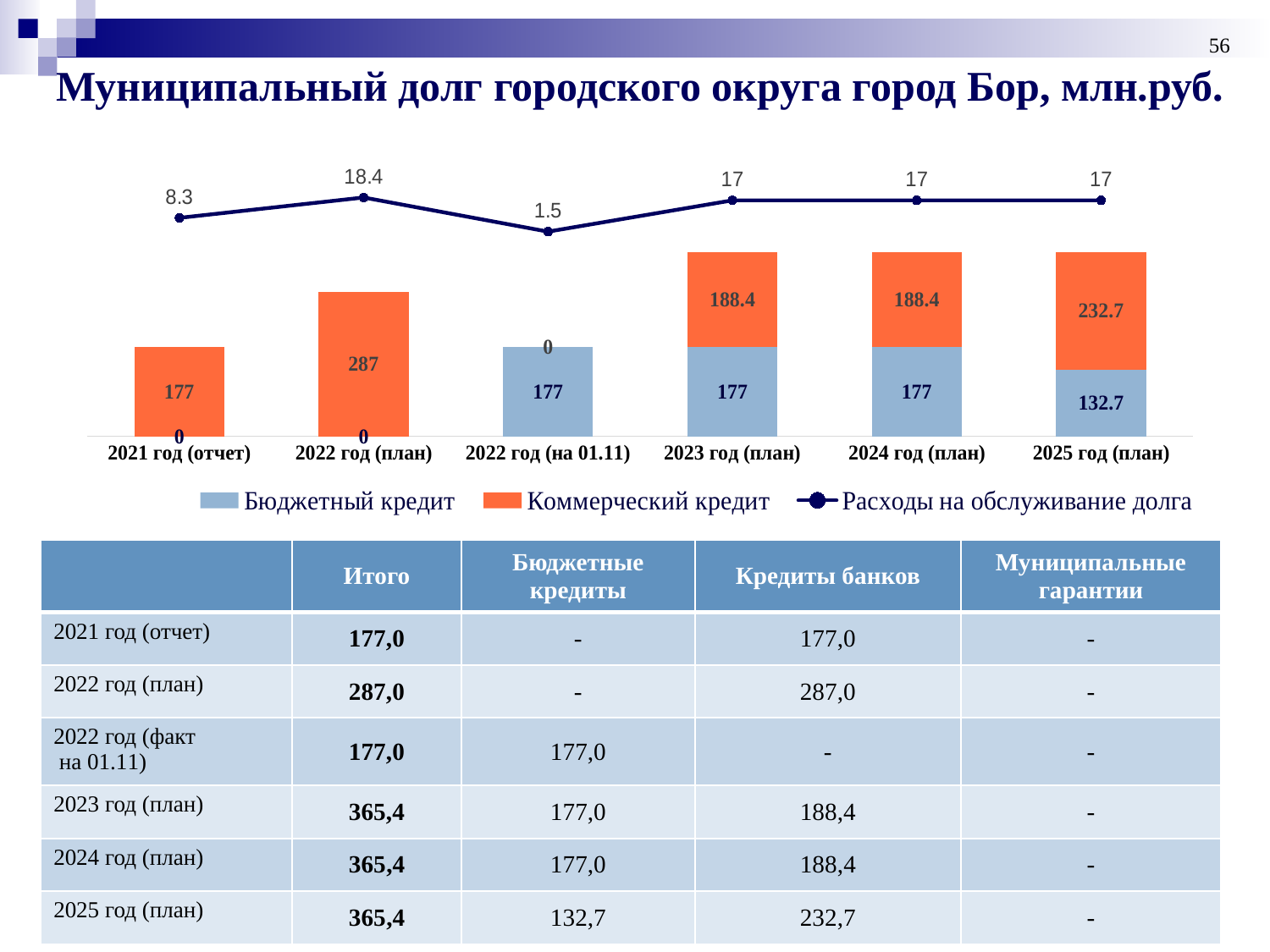
What is the value of Бюджетный кредит for 2025 год (план)? 132.7 Which is larger: Коммерческий кредит for 2022 год (план) or Коммерческий кредит for 2025 год (план)? 2022 год (план) How many categories are shown on the x axis of the chart? 6 How many series does the chart legend list? 3 What is the total of the stacked bar for 2023 год (план)? 365.4 What type of chart is used to show Бюджетный кредит and Коммерческий кредит? Stacked bar chart Which category has the lowest value of Расходы на обслуживание долга? 2022 год (на 01.11) What is the value of Коммерческий кредит for 2022 год (план)? 287 What is the difference between Коммерческий кредит for 2025 год (план) and for 2023 год (план)? 44.3 Which category has the highest value of Расходы на обслуживание долга? 2022 год (план) What is the value of Расходы на обслуживание долга for 2022 год (план)? 18.4 What is the value of Расходы на обслуживание долга for 2021 год (отчет)? 8.3